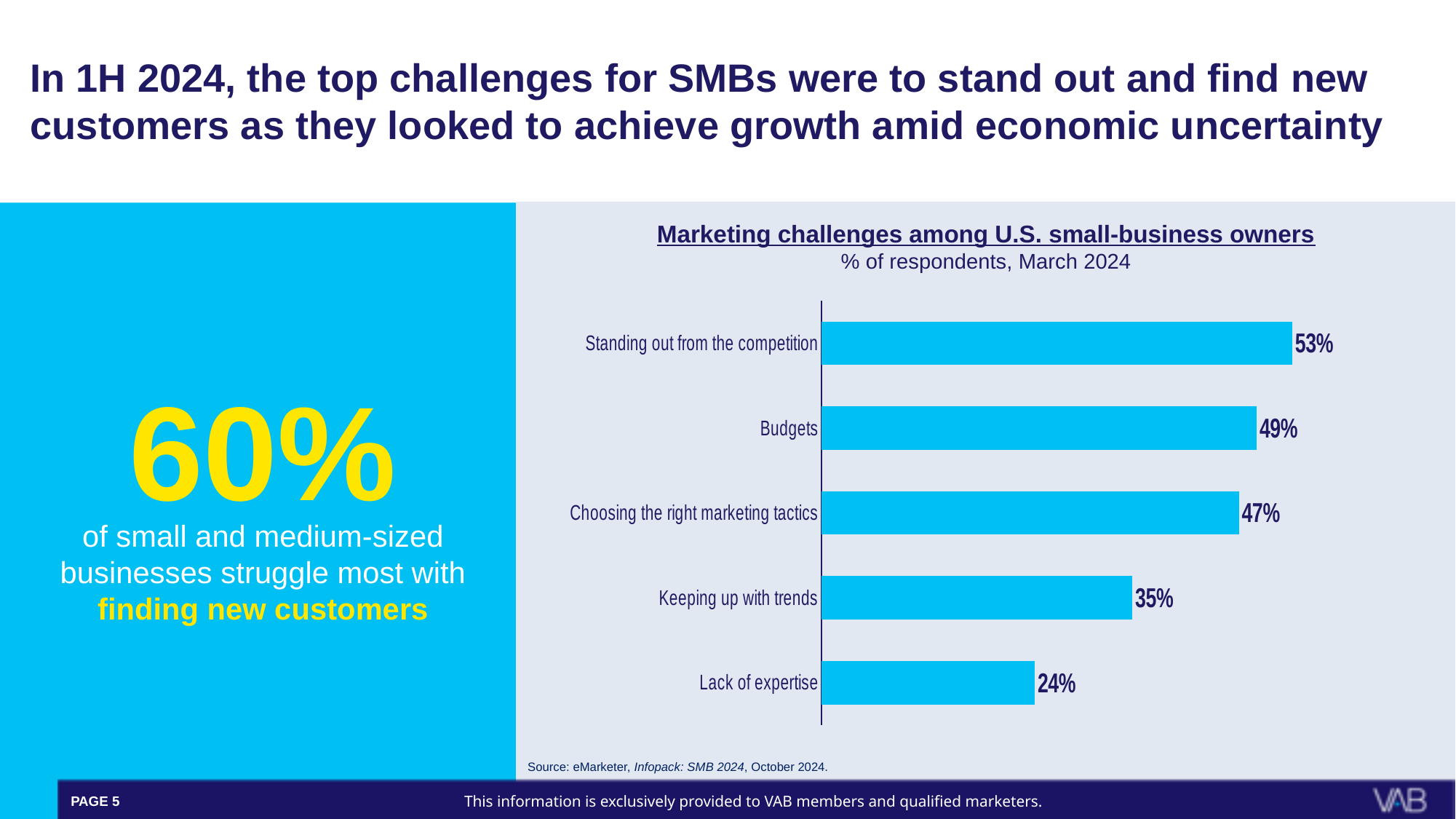
What is the difference between Budgets and Choosing the right marketing tactics? 2 percentage points Which has a larger share of respondents: Keeping up with trends or Lack of expertise? Keeping up with trends What is the value for Budgets? 49% What is the value for Lack of expertise? 24% What type of chart is used to show the marketing challenges? Bar chart Which marketing challenge has the lowest percentage of respondents? Lack of expertise How many marketing challenges are shown in the chart? 5 What percentage of respondents cited Keeping up with trends? 35% What percentage of respondents cited Standing out from the competition as a marketing challenge? 53% Which marketing challenge has the highest percentage of respondents? Standing out from the competition What is the title of the chart? Marketing challenges among U.S. small-business owners What is the difference in percentage points between Standing out from the competition and Lack of expertise? 29 percentage points